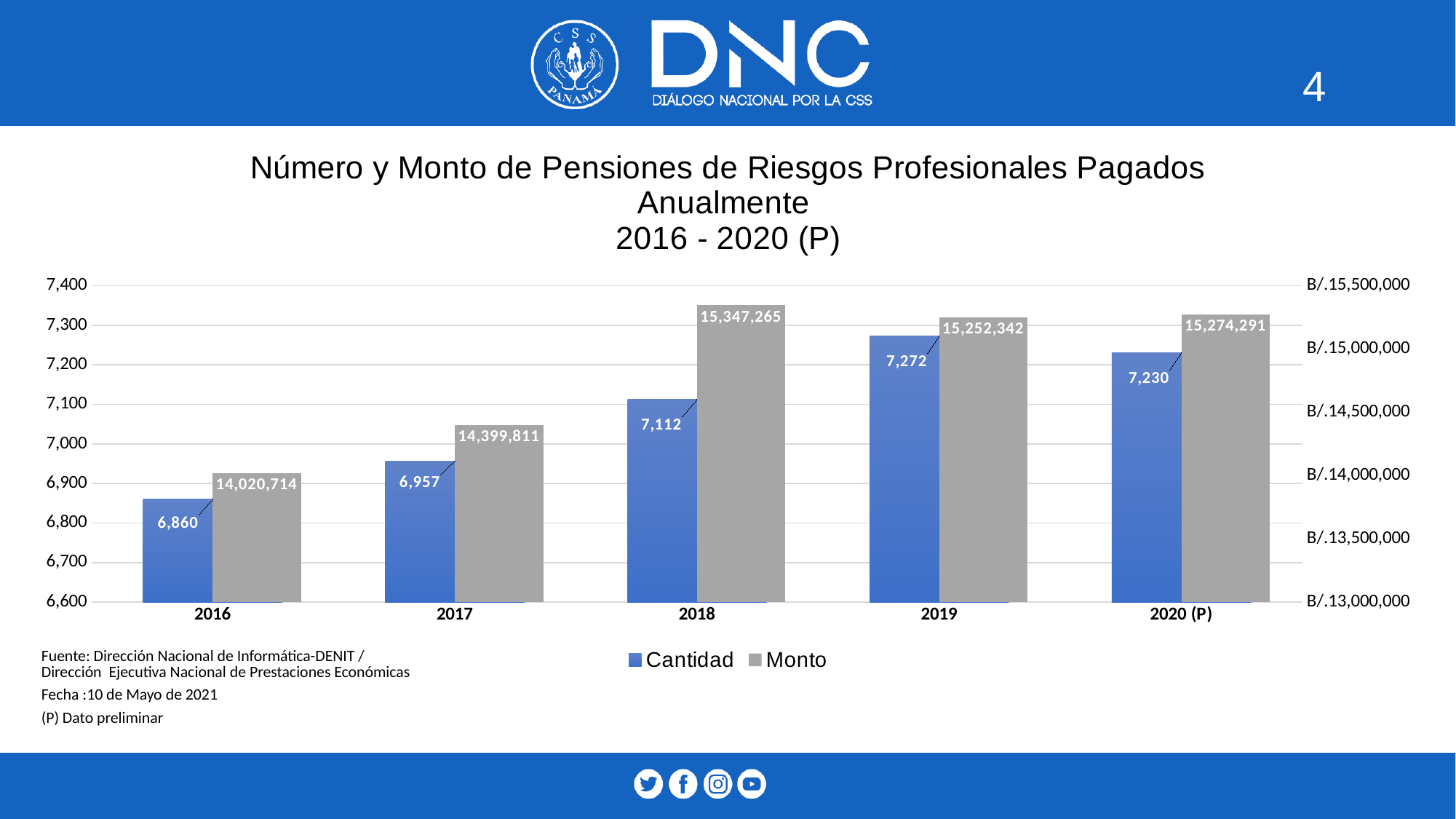
How many years are shown on the x axis? 5 What is the Monto value for 2018? 15,347,265 What is the Cantidad value for 2020 (P)? 7,230 Which is larger, the Monto value for 2019 or for 2020 (P)? 2020 (P) Does the Cantidad value rise or fall from 2016 to 2019? Rise Which year has the highest Cantidad value? 2019 Which year has the lowest Monto value? 2016 What is the Cantidad value for 2016? 6,860 How many series does the legend list? 2 What is the difference between the Cantidad values for 2019 and 2020 (P)? 42 What kind of chart is shown on the slide? Bar chart What is the difference between the Monto values for 2018 and 2020 (P)? 72,974